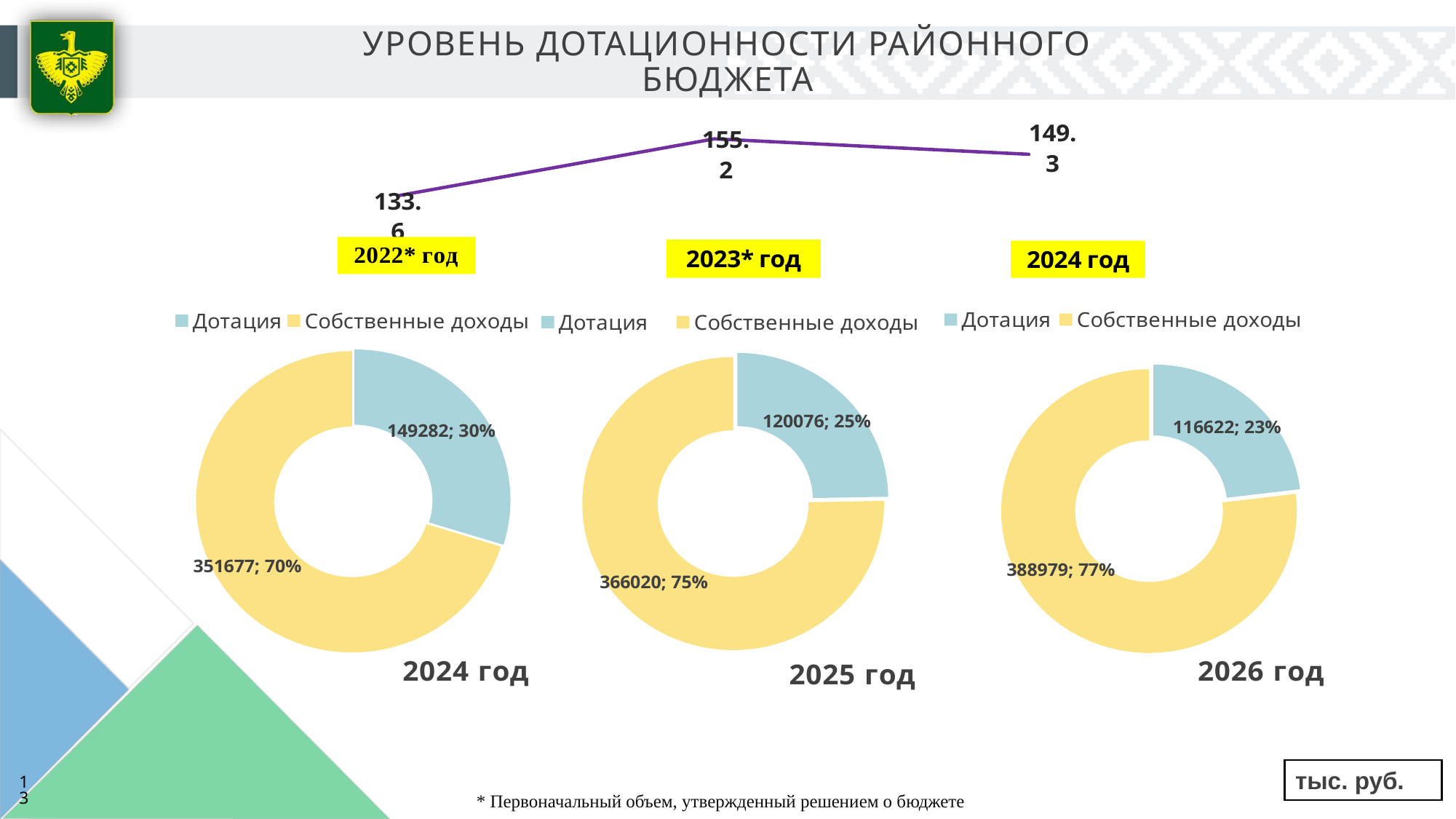
How many data points does the line chart at the top of the slide have? 3 In the doughnut chart titled "2026 год", what is the difference between Собственные доходы and Дотация? 272357 In the doughnut chart titled "2025 год", which is larger, Дотация or Собственные доходы? Собственные доходы In the doughnut chart titled "2024 год", what is the total of the two segments? 500959 How many series does the legend of the doughnut chart titled "2026 год" list? 2 In the line chart at the top of the slide, which year has the lowest value? 2022* год In the doughnut chart titled "2026 год", what share does Дотация have? 23% In the line chart at the top of the slide, what is the value for 2023* год? 155.2 In the doughnut chart titled "2024 год", what share does Собственные доходы have? 70% In the doughnut chart titled "2024 год", what is the value for Дотация? 149282 What kind of chart is the chart at the top of the slide with the purple line? line chart In the doughnut chart titled "2025 год", what is the value for Собственные доходы? 366020